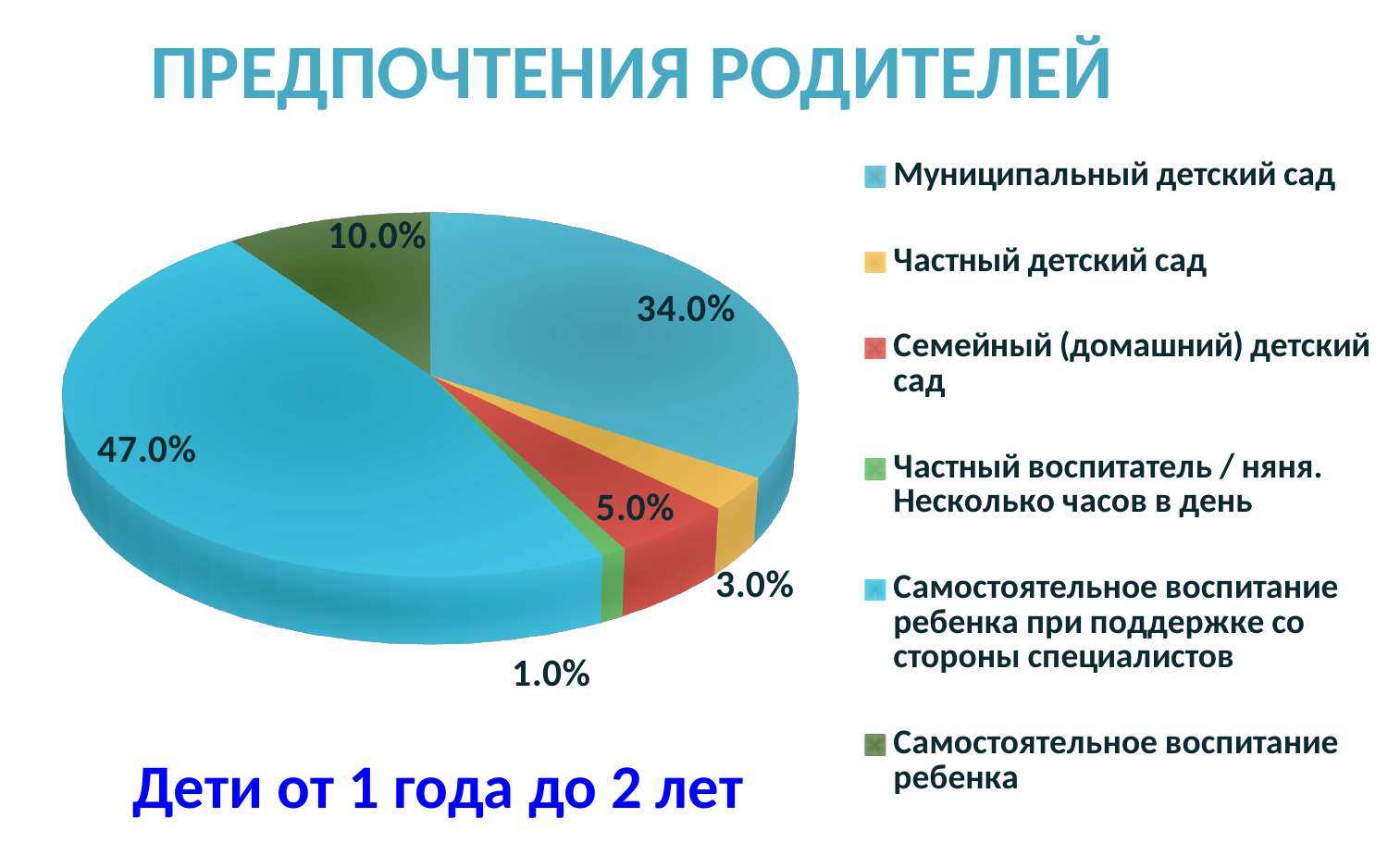
What is the difference in percentage points between "Самостоятельное воспитание ребенка при поддержке со стороны специалистов" and "Муниципальный детский сад"? 13.0% Which is larger: the slice for "Семейный (домашний) детский сад" or the slice for "Частный детский сад"? Семейный (домашний) детский сад What share of the pie does "Семейный (домашний) детский сад" have? 5.0% Which category has the largest slice of the pie? Самостоятельное воспитание ребенка при поддержке со стороны специалистов What share of the pie does "Частный детский сад" have? 3.0% Which category has the smallest slice of the pie? Частный воспитатель / няня. Несколько часов в день What share of the pie does "Муниципальный детский сад" have? 34.0% How many categories does the legend list? 6 What kind of chart is shown on the slide? Pie chart